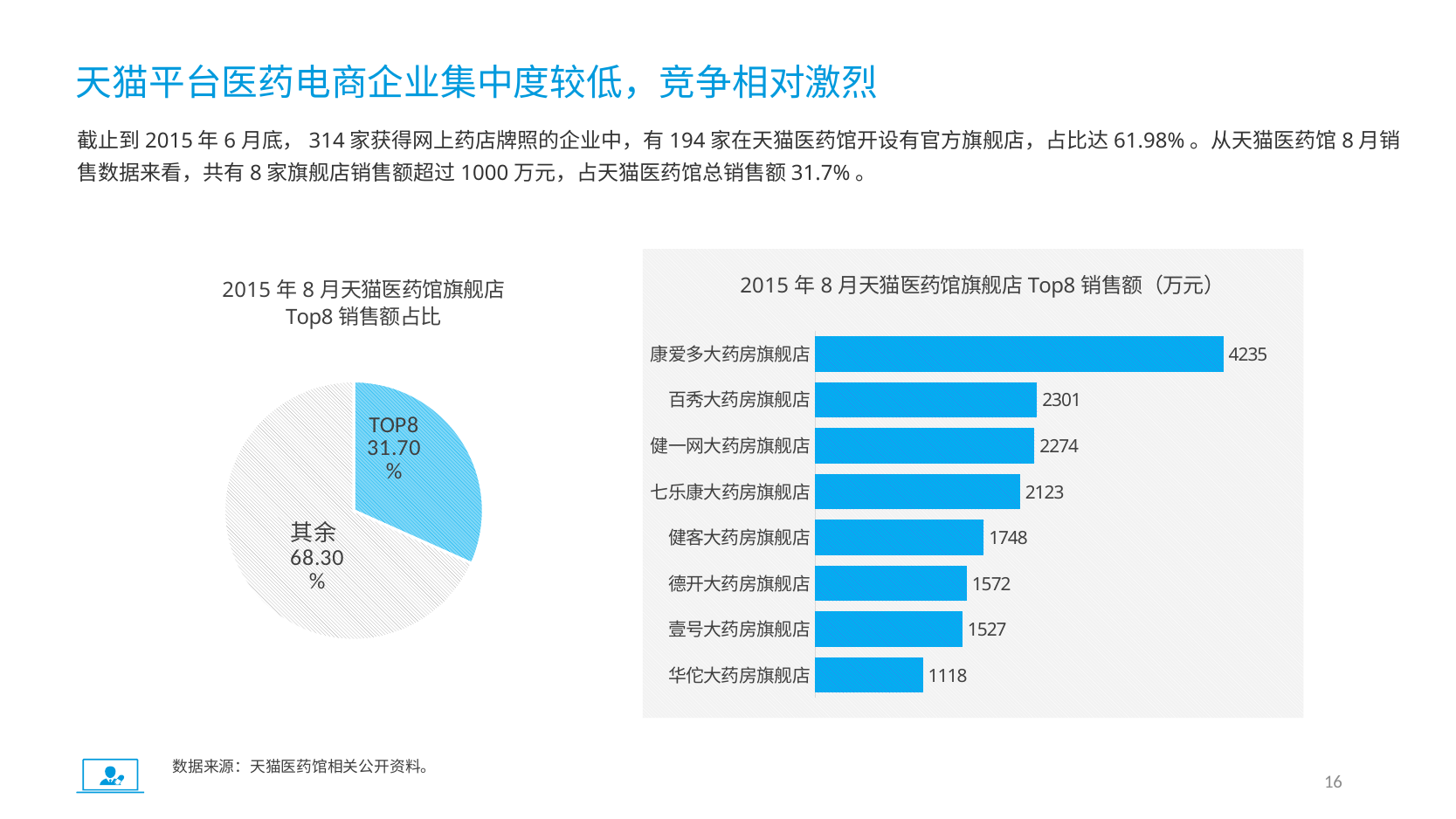
How many stores are shown in the bar chart on the right? 8 In the pie chart on the left, what share does TOP8 account for? 31.70% In the bar chart on the right, what is the sales value for 康爱多大药房旗舰店? 4235 In the bar chart on the right, which store has the highest sales? 康爱多大药房旗舰店 In the bar chart on the right, which store has the lowest sales? 华佗大药房旗舰店 In the pie chart on the left, what share does 其余 account for? 68.30% What type of chart is the chart on the right? Bar chart In the bar chart on the right, what is the sales value for 健客大药房旗舰店? 1748 In the bar chart on the right, what is the difference in sales between 康爱多大药房旗舰店 and 百秀大药房旗舰店? 1934 What is the title of the chart on the right? 2015 年 8 月天猫医药馆旗舰店 Top8 销售额（万元） In the bar chart on the right, which has higher sales, 七乐康大药房旗舰店 or 健客大药房旗舰店? 七乐康大药房旗舰店 In the bar chart on the right, what is the difference in sales between 德开大药房旗舰店 and 壹号大药房旗舰店? 45